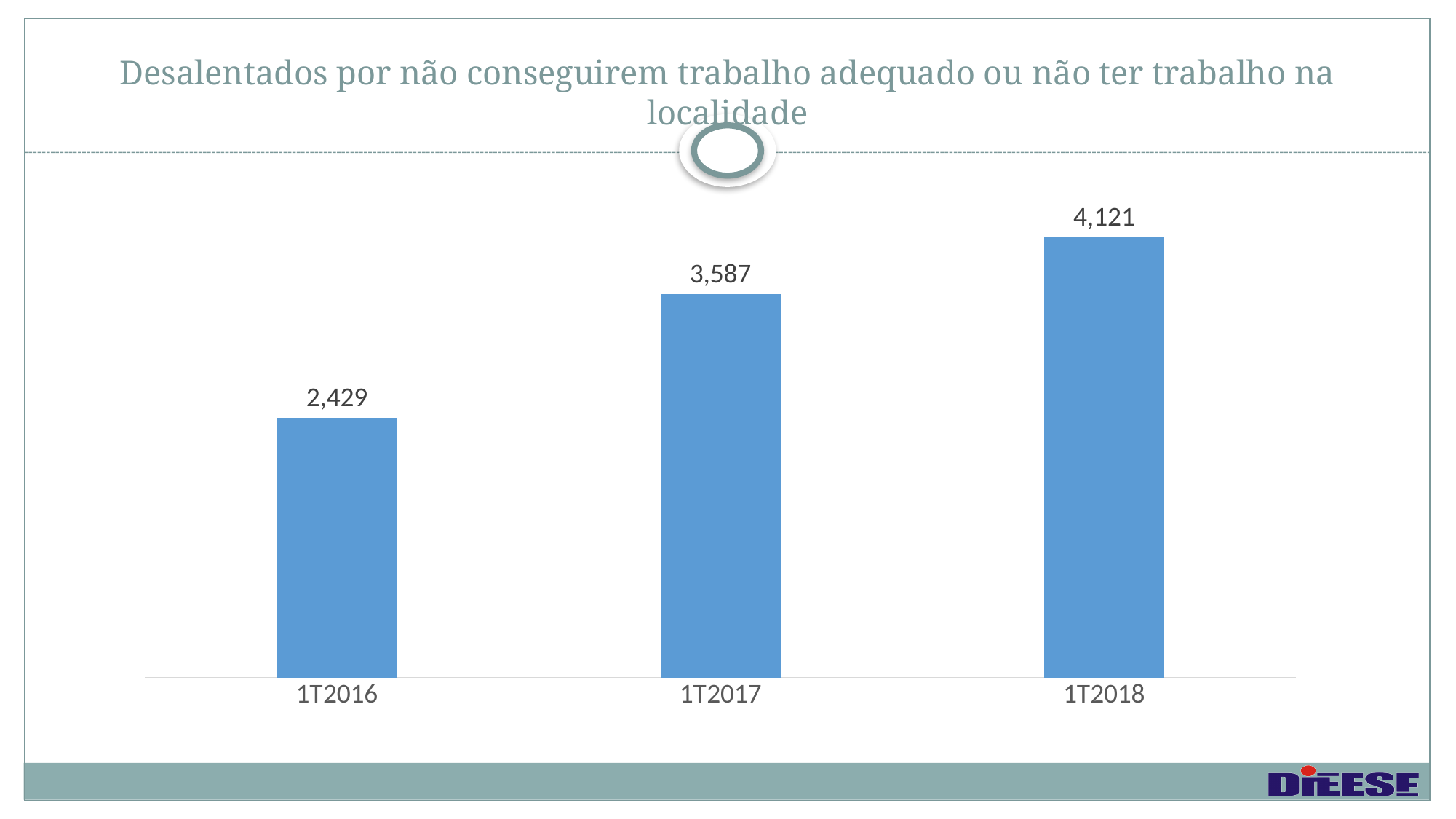
Which category has the highest value? 1T2018 What kind of chart is shown on the slide? bar chart Do the values rise or fall from 1T2016 to 1T2018? rise How many categories are shown on the x axis? 3 What is the value for 1T2016? 2,429 What is the difference between the values for 1T2017 and 1T2016? 1,158 Which category has the lowest value? 1T2016 What is the value for 1T2018? 4,121 Which is larger, the value for 1T2017 or the value for 1T2016? 1T2017 What is the difference between the values for 1T2018 and 1T2017? 534 What is the difference between the values for 1T2018 and 1T2016? 1,692 What is the value for 1T2017? 3,587